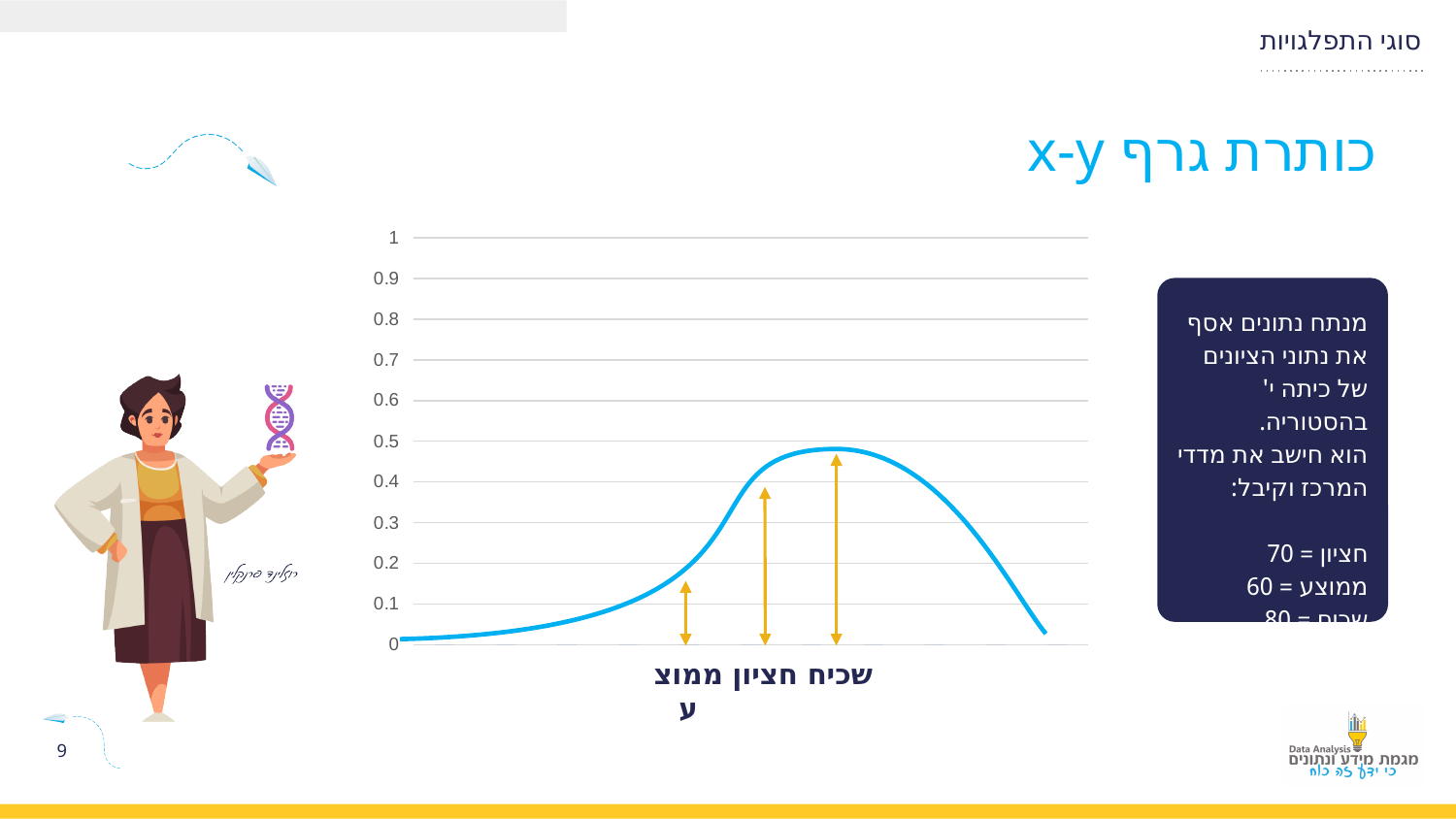
How many vertical arrows are drawn under the curve? 3 Does the curve rise or fall from the left edge up to its peak? rises Is the value of the curve at its right end greater or less than 0.1? less What is the title of the chart? כותרת גרף x-y How many tick labels are shown on the y axis? 11 Does the curve rise or fall after its peak toward the right edge? falls Is the peak value of the curve greater or less than 0.4? greater Of the three marked positions (ממוצע, חציון, שכיח), which one is at the highest point of the curve? שכיח What is the highest tick value shown on the y axis? 1 Is the value of the curve at the leftmost arrow (ממוצע) greater or less than 0.2? less How many lines (data series) are plotted on the chart? 1 What kind of chart is shown on the slide? line chart